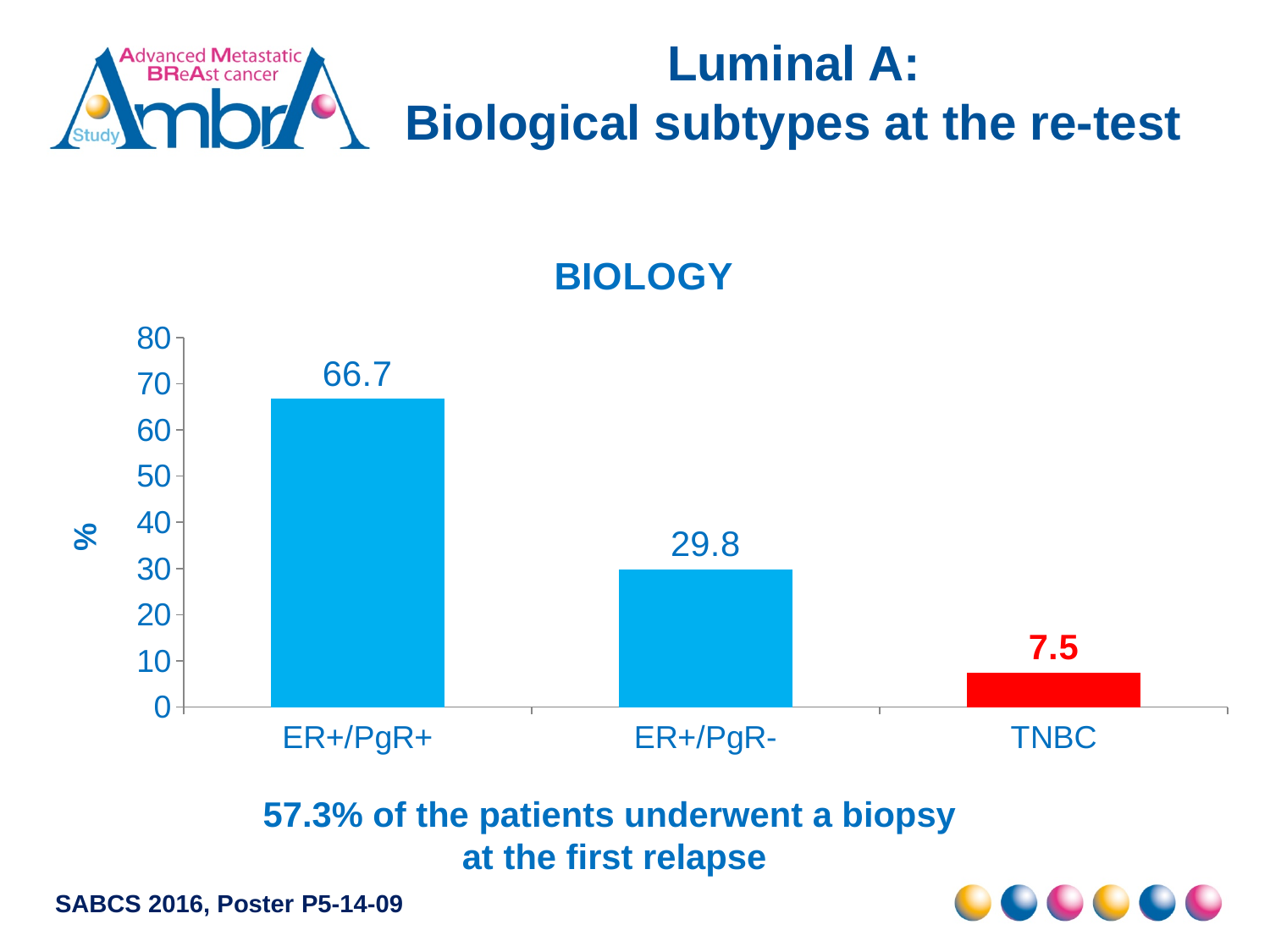
How many categories are shown in the BIOLOGY chart? 3 What is the difference between the values for ER+/PgR+ and ER+/PgR- in the BIOLOGY chart? 36.9 Which category has the lowest value in the BIOLOGY chart? TNBC What is the label on the vertical axis of the BIOLOGY chart? % What is the value for ER+/PgR- in the BIOLOGY chart? 29.8 What is the value for TNBC in the BIOLOGY chart? 7.5 What is the value for ER+/PgR+ in the BIOLOGY chart? 66.7 Which category has the highest value in the BIOLOGY chart? ER+/PgR+ What kind of chart is the BIOLOGY chart? bar chart What is the difference between the values for ER+/PgR- and TNBC in the BIOLOGY chart? 22.3 Which is larger in the BIOLOGY chart, the value for ER+/PgR- or the value for TNBC? ER+/PgR- Is the value for ER+/PgR- greater or less than 30 in the BIOLOGY chart? less